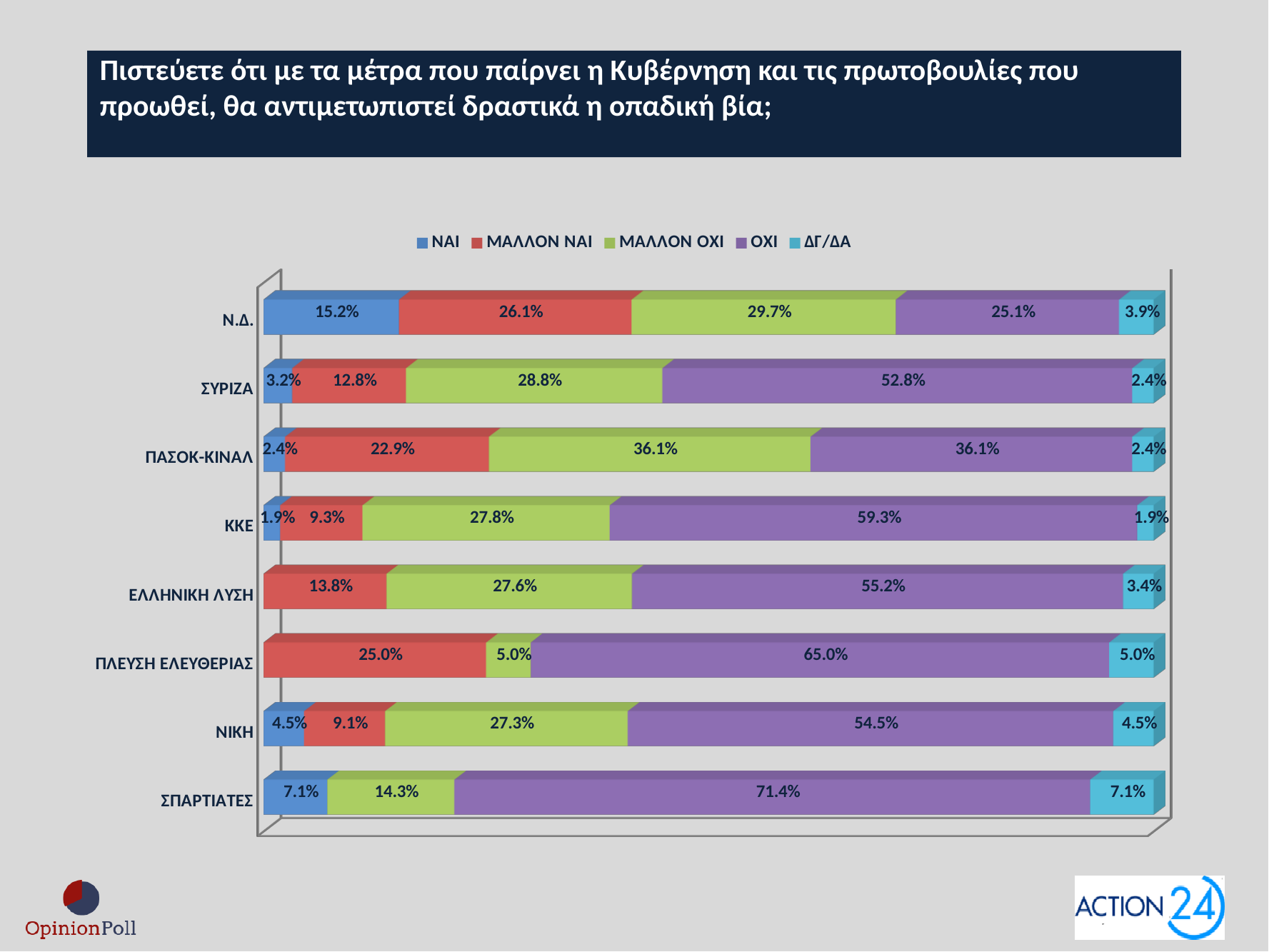
What is the ΜΑΛΛΟΝ ΟΧΙ value for ΠΑΣΟΚ-ΚΙΝΑΛ? 36.1% What kind of chart is shown on the slide? Stacked bar chart What is the ΟΧΙ value for ΣΥΡΙΖΑ? 52.8% Which is larger: the ΟΧΙ value for ΚΚΕ or the ΟΧΙ value for ΝΙΚΗ? ΚΚΕ Among the categories with a ΝΑΙ label, which has the lowest ΝΑΙ value? ΚΚΕ Which category has the highest ΟΧΙ value? ΣΠΑΡΤΙΑΤΕΣ What is the difference between the ΜΑΛΛΟΝ ΟΧΙ and ΝΑΙ values for Ν.Δ.? 14.5% How many categories (parties) are shown on the chart? 8 What is the ΔΓ/ΔΑ value for ΠΛΕΥΣΗ ΕΛΕΥΘΕΡΙΑΣ? 5.0% What is the ΝΑΙ value for Ν.Δ.? 15.2% Which category has the highest ΝΑΙ value? Ν.Δ. How many series does the legend list? 5